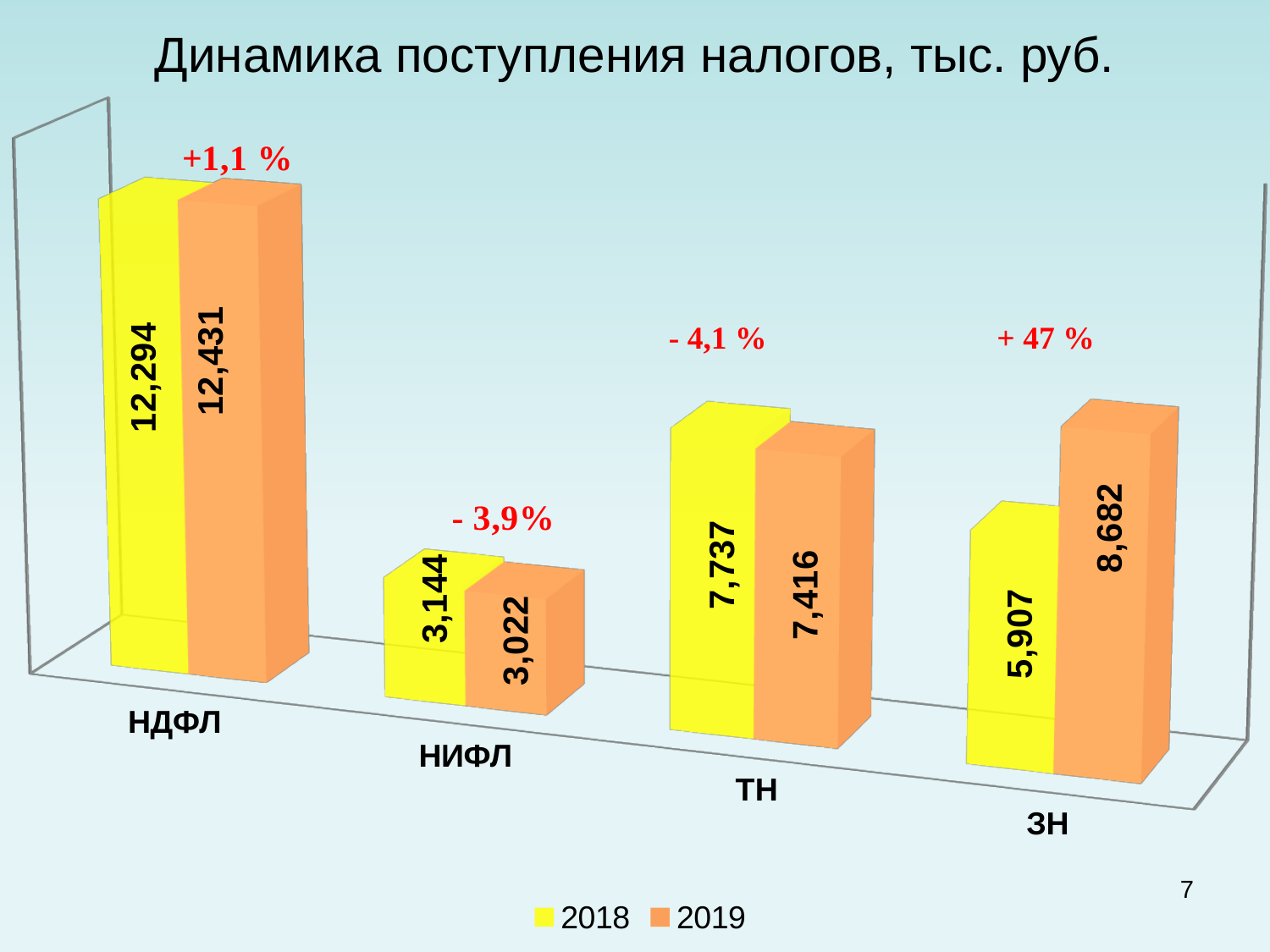
What is the difference between the 2019 and 2018 values for ЗН? 2,775 What is the 2018 value for НДФЛ? 12,294 Which category has the highest 2019 value? НДФЛ What is the 2019 value for НИФЛ? 3,022 What kind of chart is shown on the slide? Bar chart Which category has the lowest 2018 value? НИФЛ What is the 2019 value for ЗН? 8,682 How many categories are shown on the x axis? 4 For ТН, which is larger: the 2018 value or the 2019 value? 2018 What percentage change is annotated above the ЗН bars? + 47 % How many series does the legend list? 2 What is the difference between the 2018 and 2019 values for ТН? 321